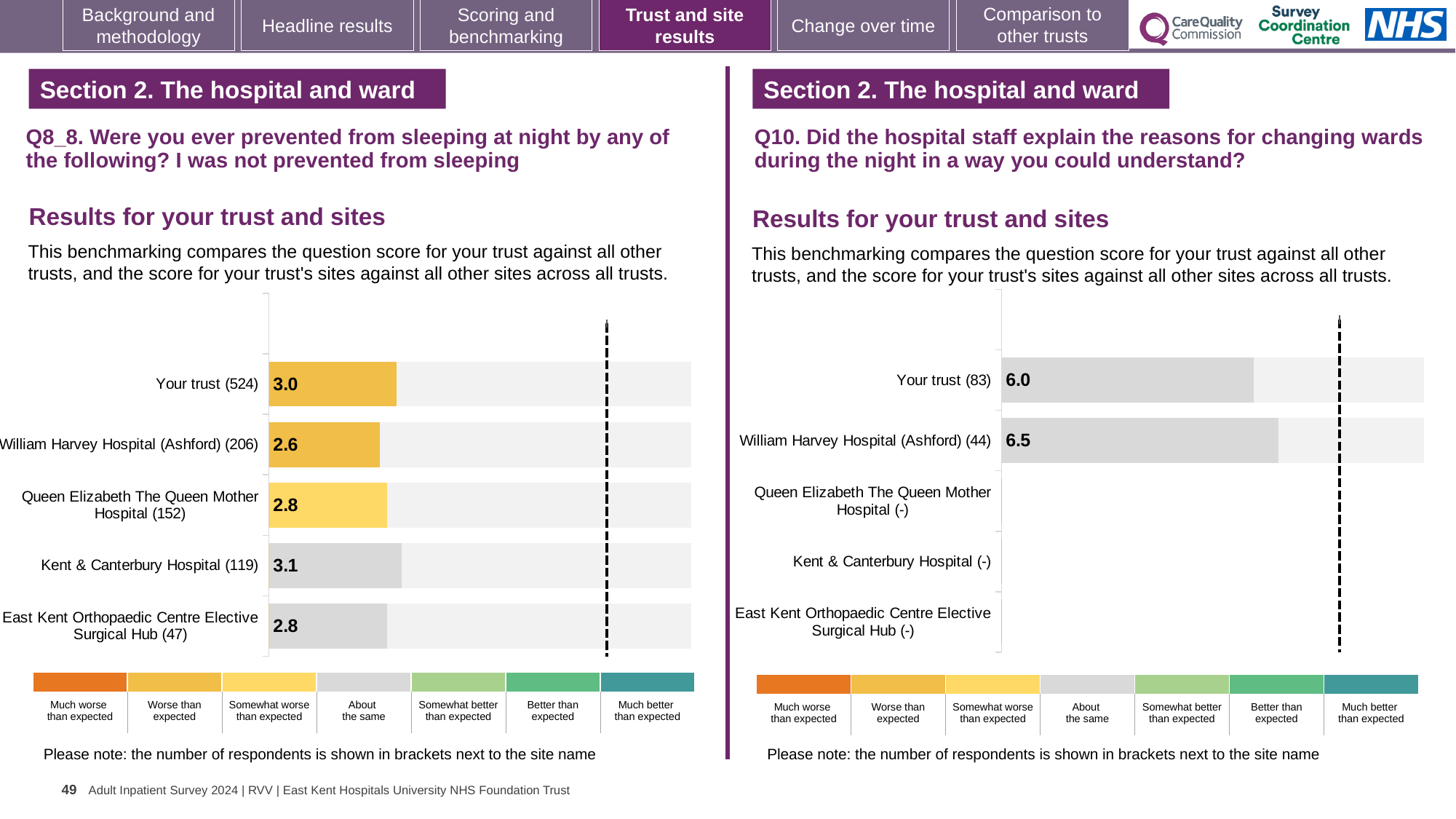
On the Q8_8 chart (left), what is the score for William Harvey Hospital (Ashford)? 2.6 On the Q10 chart (right), what is the score for William Harvey Hospital (Ashford)? 6.5 On the Q8_8 chart (left), which site has the lowest score? William Harvey Hospital (Ashford) On the Q8_8 chart (left), which site has the highest score? Kent & Canterbury Hospital On the Q10 chart (right), which is larger: the score for Your trust or for William Harvey Hospital (Ashford)? William Harvey Hospital (Ashford) What type of chart is used on the Q10 chart (right)? Bar chart On the Q10 chart (right), what is the score for Your trust? 6.0 On the Q8_8 chart (left), how many bars are plotted? 5 On the Q8_8 chart (left), what is the difference between the scores for Kent & Canterbury Hospital and William Harvey Hospital (Ashford)? 0.5 On the Q8_8 chart (left), what colour is the bar for Queen Elizabeth The Queen Mother Hospital? Yellow On the Q8_8 chart (left), what is the score for Your trust? 3.0 On the Q10 chart (right), what is the difference between the scores for William Harvey Hospital (Ashford) and Your trust? 0.5